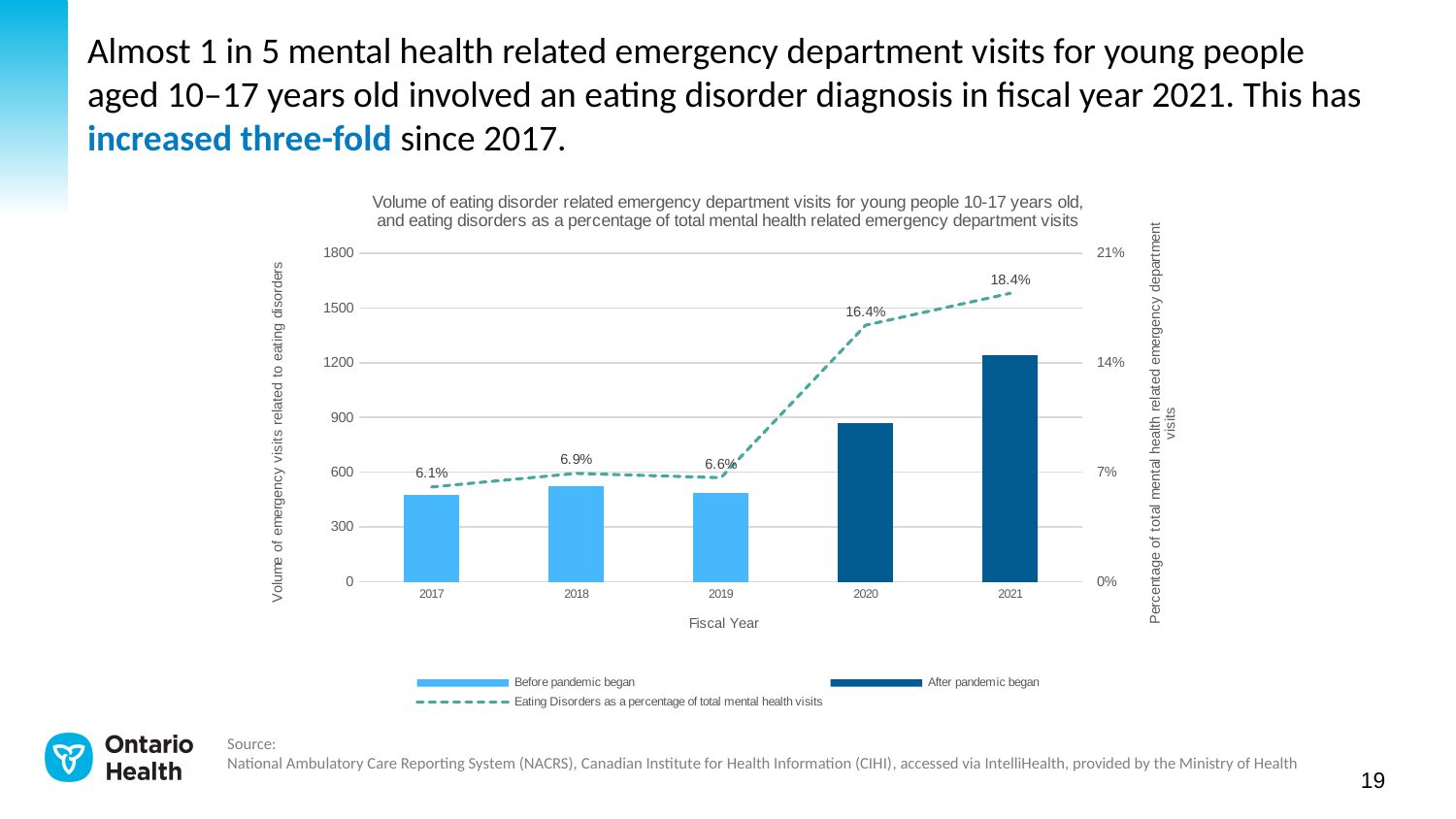
Is the volume of eating disorder related emergency visits in fiscal year 2021 greater or less than 1200? greater In which fiscal year is the eating disorder percentage of total mental health visits highest? 2021 In which fiscal year is the eating disorder percentage of total mental health visits lowest? 2017 What is the eating disorder percentage data label shown for fiscal year 2020? 16.4% How many fiscal years are shown on the x axis of the chart? 5 What is the eating disorder percentage data label shown for fiscal year 2017? 6.1% By how many percentage points did the eating disorder percentage increase from fiscal year 2019 to fiscal year 2020? 9.8 percentage points Is the volume of eating disorder related emergency visits in fiscal year 2017 greater or less than 600? less Which fiscal year has the taller bar for volume of eating disorder related emergency visits, 2020 or 2021? 2021 How many entries does the chart legend list? 3 What percentage of total mental health visits did eating disorders represent in fiscal year 2021? 18.4% Which legend entry is represented by the dashed line in the chart? Eating Disorders as a percentage of total mental health visits